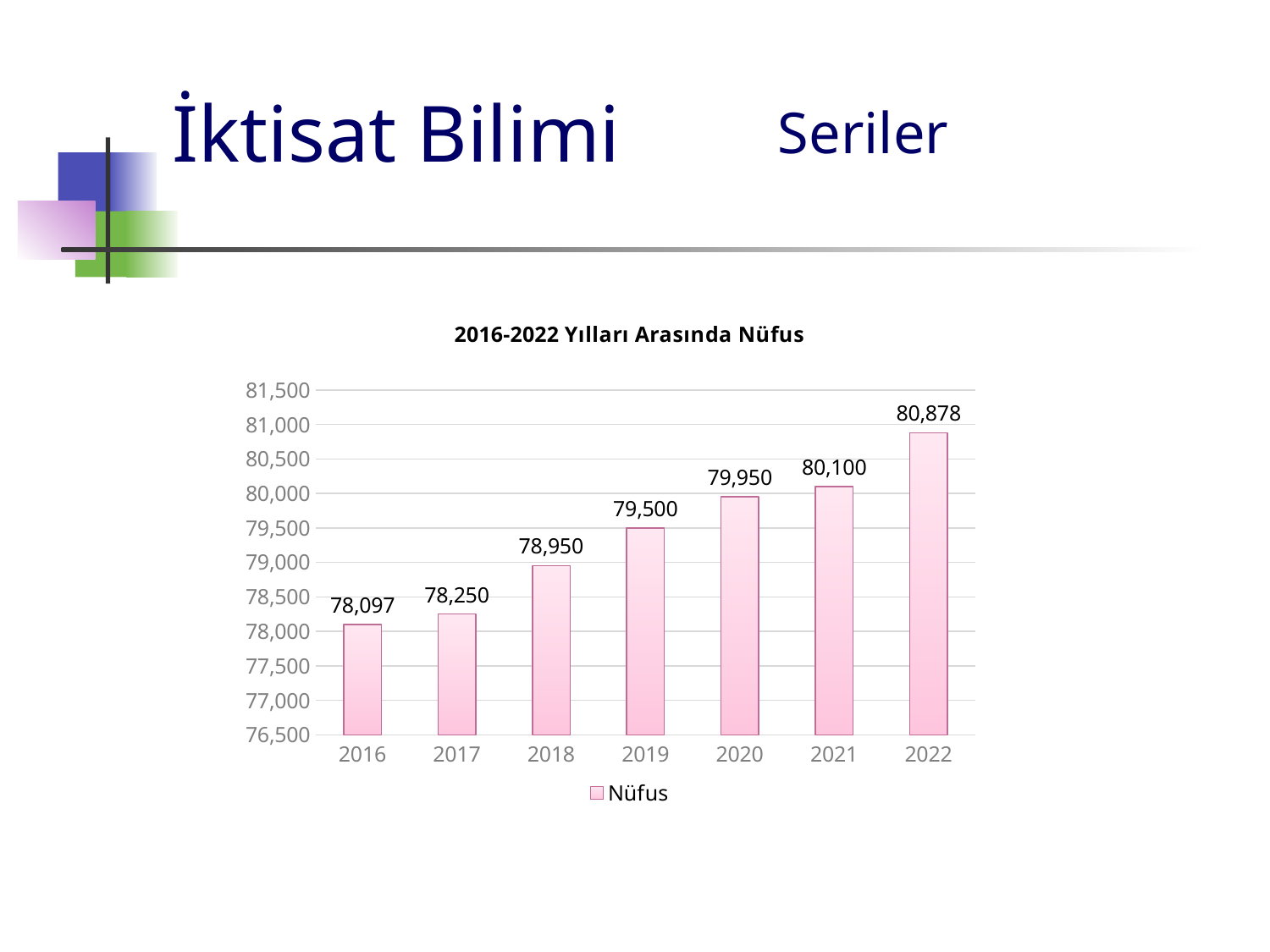
Do the values rise or fall from 2016 to 2022? rise What is the difference between the values for 2022 and 2016? 2,781 What is the value for 2022? 80,878 What is the value for 2019? 79,500 What is the value for 2016? 78,097 Which year has the lowest value? 2016 Is the value for 2021 greater or less than 80,000? greater Which is larger, the value for 2018 or the value for 2020? 2020 How many years are shown on the x axis? 7 What kind of chart is shown? bar chart What is the difference between the values for 2021 and 2020? 150 Which year has the highest value? 2022